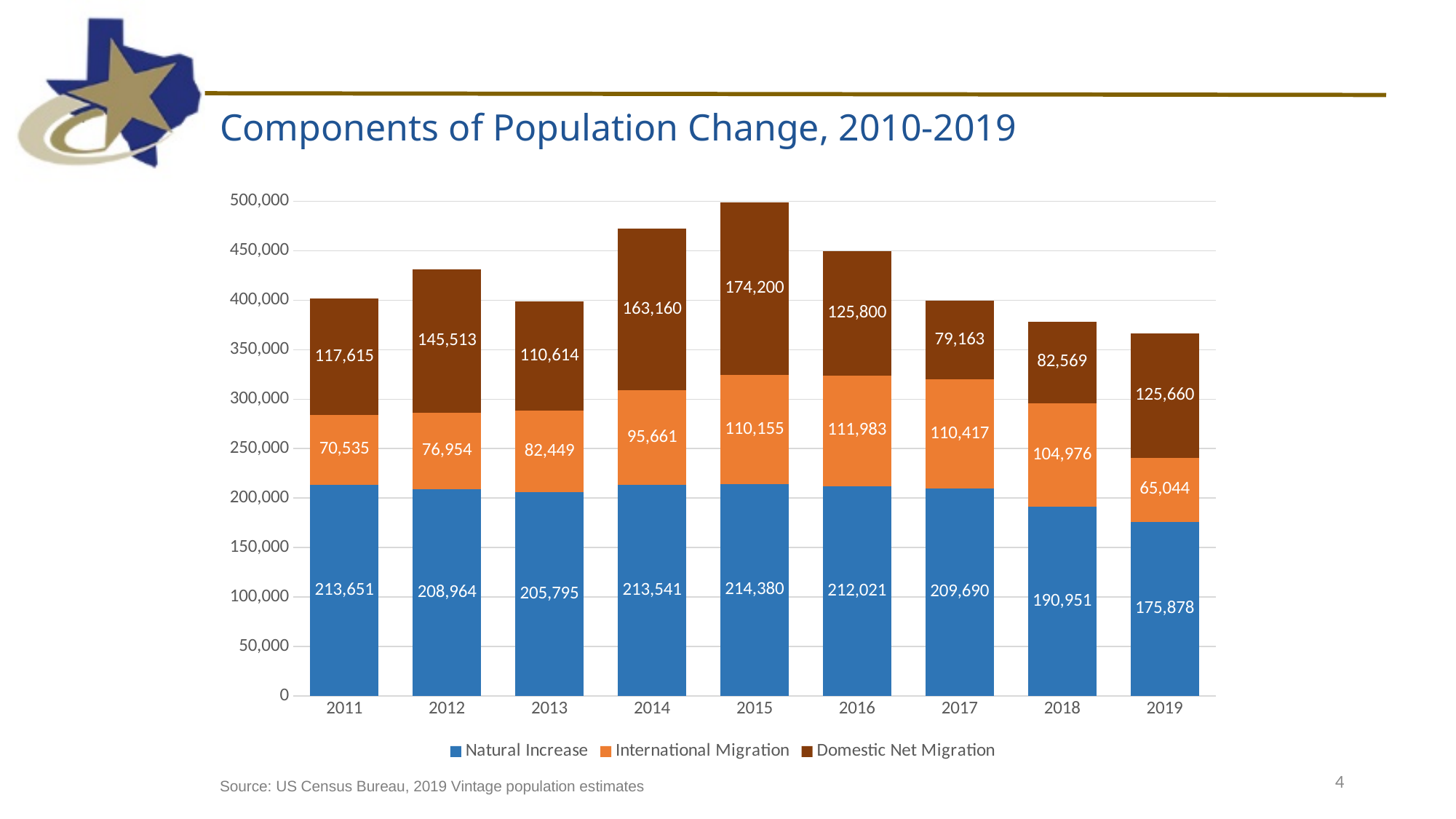
Which year has the highest Domestic Net Migration value? 2015 What is the Domestic Net Migration value for 2012? 145,513 How many series does the legend list? 3 What is the Natural Increase value for 2015? 214,380 How many years are shown on the x axis? 9 What is the International Migration value for 2018? 104,976 Is the total height of the 2015 stacked bar greater or less than 450,000? greater What is the difference between the International Migration values for 2015 and 2011? 39,620 What kind of chart is shown on the slide? Stacked bar chart Which is larger, the Domestic Net Migration value for 2014 or for 2016? 2014 Which year has the lowest Natural Increase value? 2019 What is the total of the stacked bar for 2011? 401,801